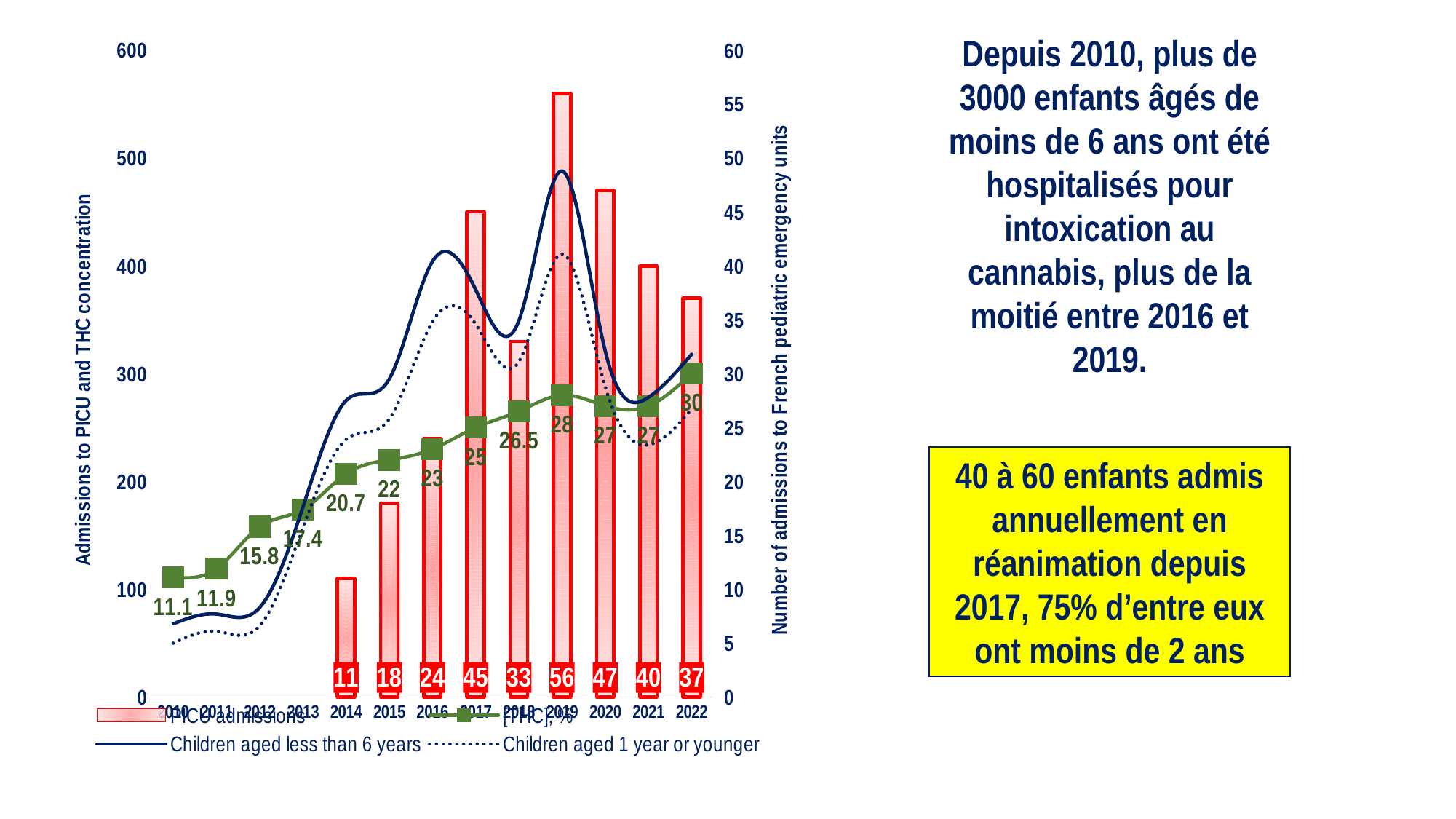
Does the [THC], % line rise or fall from 2010 to 2016? Rise What is the difference in PICU admissions between 2019 and 2020? 9 Is the value of the 'Children aged less than 6 years' line for 2019 greater or less than 400? greater What is the value of PICU admissions for 2019? 56 What is the [THC], % value for 2013? 17.4 Which is larger, the PICU admissions for 2017 or for 2018? 2017 Which year has the highest PICU admissions? 2019 How many series does the legend list? 4 What kind of chart is this? Combined bar and line chart What is the label of the right-hand vertical axis? Number of admissions to French pediatric emergency units Which year has the lowest PICU admissions among the labelled bars? 2014 How many years are shown on the x axis? 13